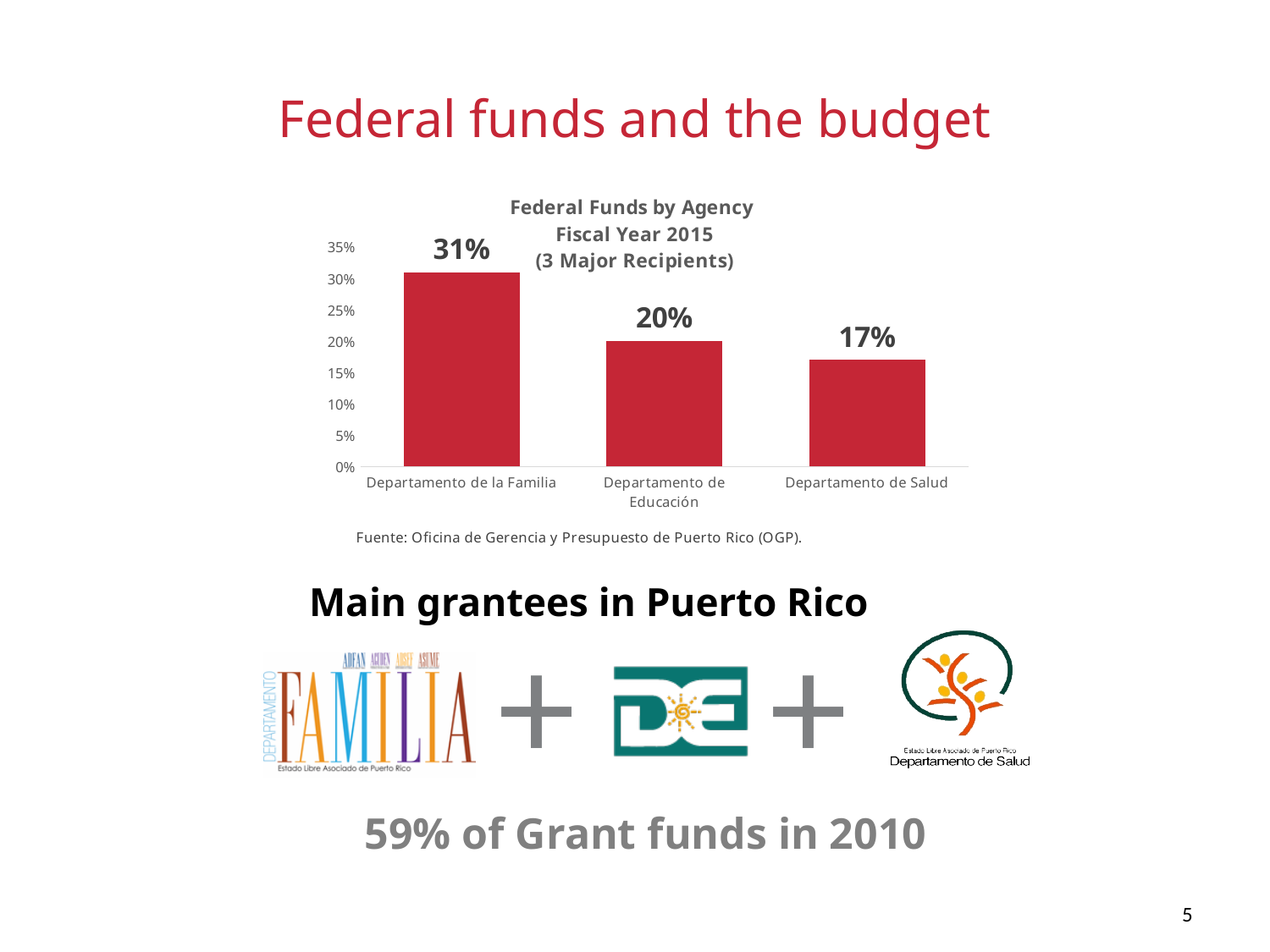
What is the difference in percentage points between Departamento de Educación and Departamento de Salud? 3 percentage points What is the title of the chart? Federal Funds by Agency Fiscal Year 2015 (3 Major Recipients) What percentage of federal funds went to Departamento de Salud? 17% Which agency received the lowest share of federal funds? Departamento de Salud Which agency received the highest share of federal funds? Departamento de la Familia Which received a larger share of federal funds, Departamento de Educación or Departamento de Salud? Departamento de Educación What percentage of federal funds went to Departamento de Educación? 20% How many agencies are shown in the chart? 3 Is the value for Departamento de la Familia greater or less than 25%? greater What is the difference in percentage points between Departamento de la Familia and Departamento de Salud? 14 percentage points What type of chart is used to show federal funds by agency? Bar chart What percentage of federal funds went to Departamento de la Familia? 31%